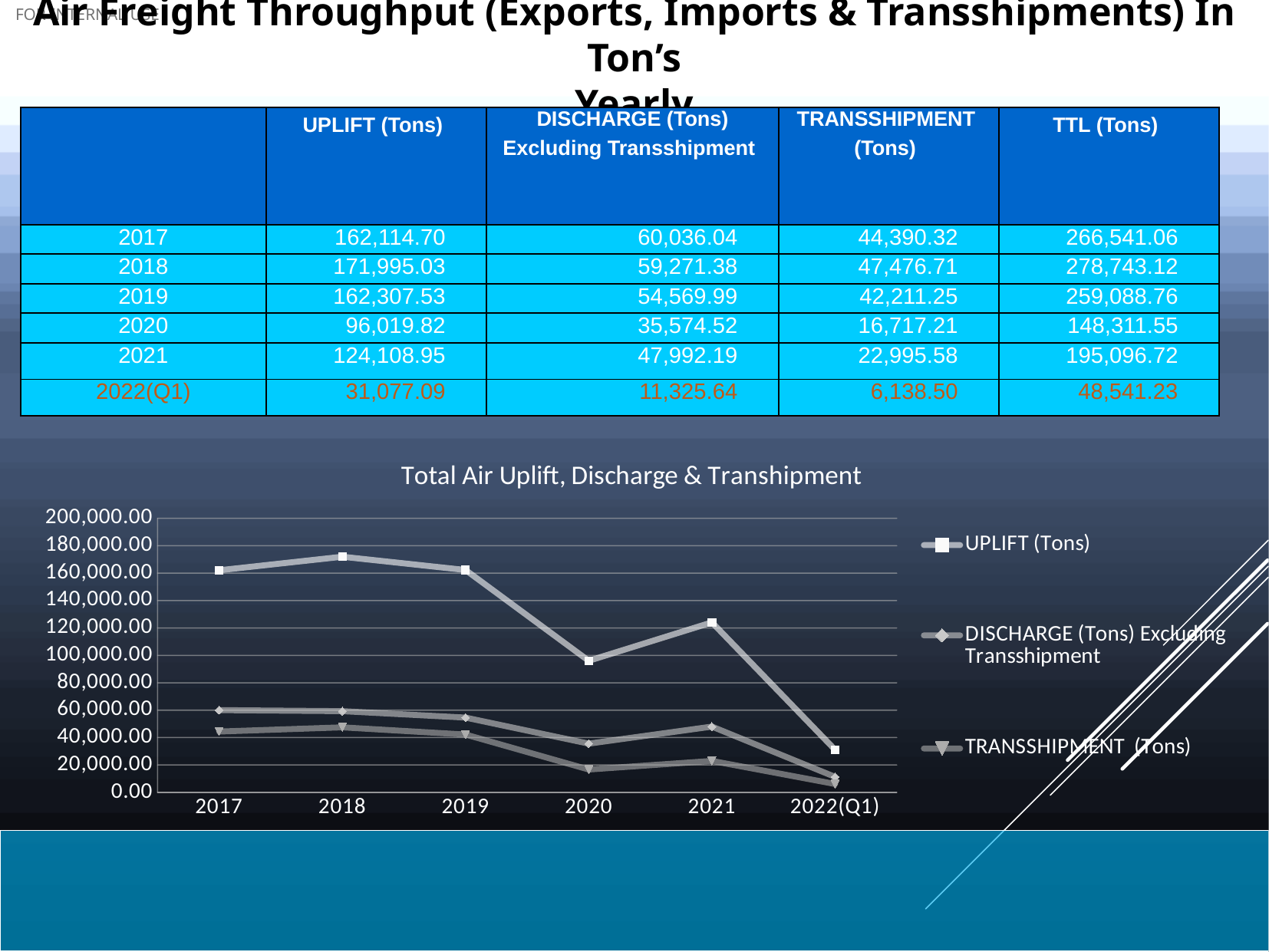
Is the UPLIFT (Tons) value for 2021 greater or less than 100,000.00? greater What is the title of the line chart? Total Air Uplift, Discharge & Transhipment What kind of chart is shown under the title 'Total Air Uplift, Discharge & Transhipment'? line chart In 2017, which series is higher: DISCHARGE (Tons) Excluding Transshipment or TRANSSHIPMENT (Tons)? DISCHARGE (Tons) Excluding Transshipment Which is larger, the UPLIFT (Tons) value for 2020 or for 2021? 2021 According to the table, what is the UPLIFT (Tons) value for 2018? 171,995.03 How many points are plotted along the x axis of the line chart? 6 In which year does the UPLIFT (Tons) line reach its highest value? 2018 Does the UPLIFT (Tons) line rise or fall from 2019 to 2020? fall At which x-axis category is the UPLIFT (Tons) line at its lowest? 2022(Q1) Is the DISCHARGE (Tons) Excluding Transshipment value for 2017 greater or less than 80,000.00? less How many series does the legend of the line chart list? 3